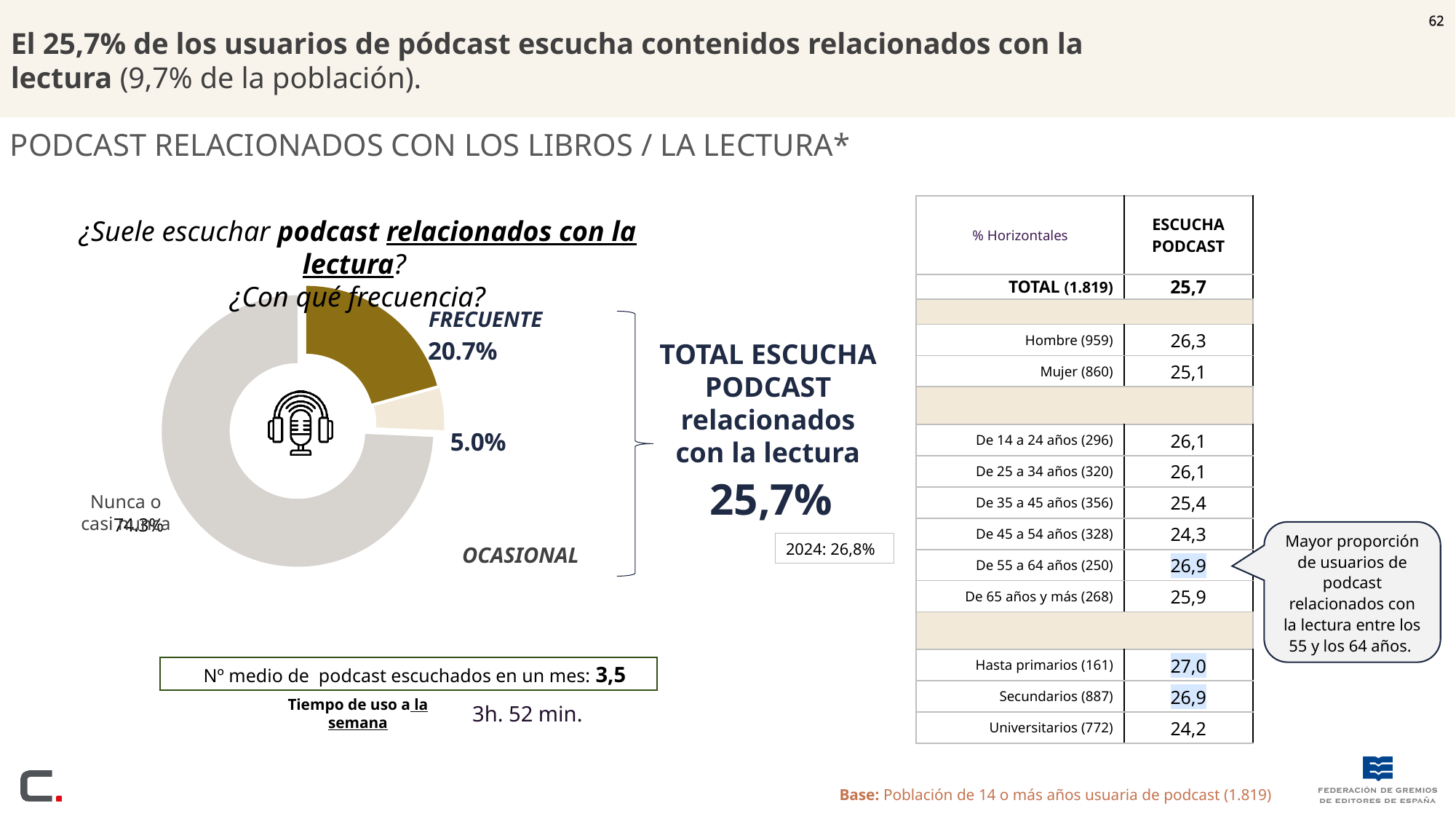
In the donut chart, what percentage corresponds to 'Nunca o casi nunca'? 74.3% In the donut chart, which is larger: FRECUENTE or OCASIONAL? FRECUENTE How many slices does the donut chart have? 3 Which slice of the donut chart is the smallest? OCASIONAL What icon is shown in the centre of the donut chart? A microphone with headphones What type of chart is used to show how often users listen to reading-related podcasts? Pie chart (donut) According to the slide, what is the combined total of FRECUENTE and OCASIONAL listeners of reading-related podcasts? 25,7% Which slice of the donut chart is the largest? Nunca o casi nunca In the donut chart, what percentage of podcast users listen to reading-related podcasts frequently (FRECUENTE)? 20.7% In the donut chart, what percentage corresponds to OCASIONAL? 5.0% In the donut chart, what is the difference in percentage points between FRECUENTE and OCASIONAL? 15.7 What was the total share of listeners of reading-related podcasts in 2024, as shown next to the donut chart? 26,8%